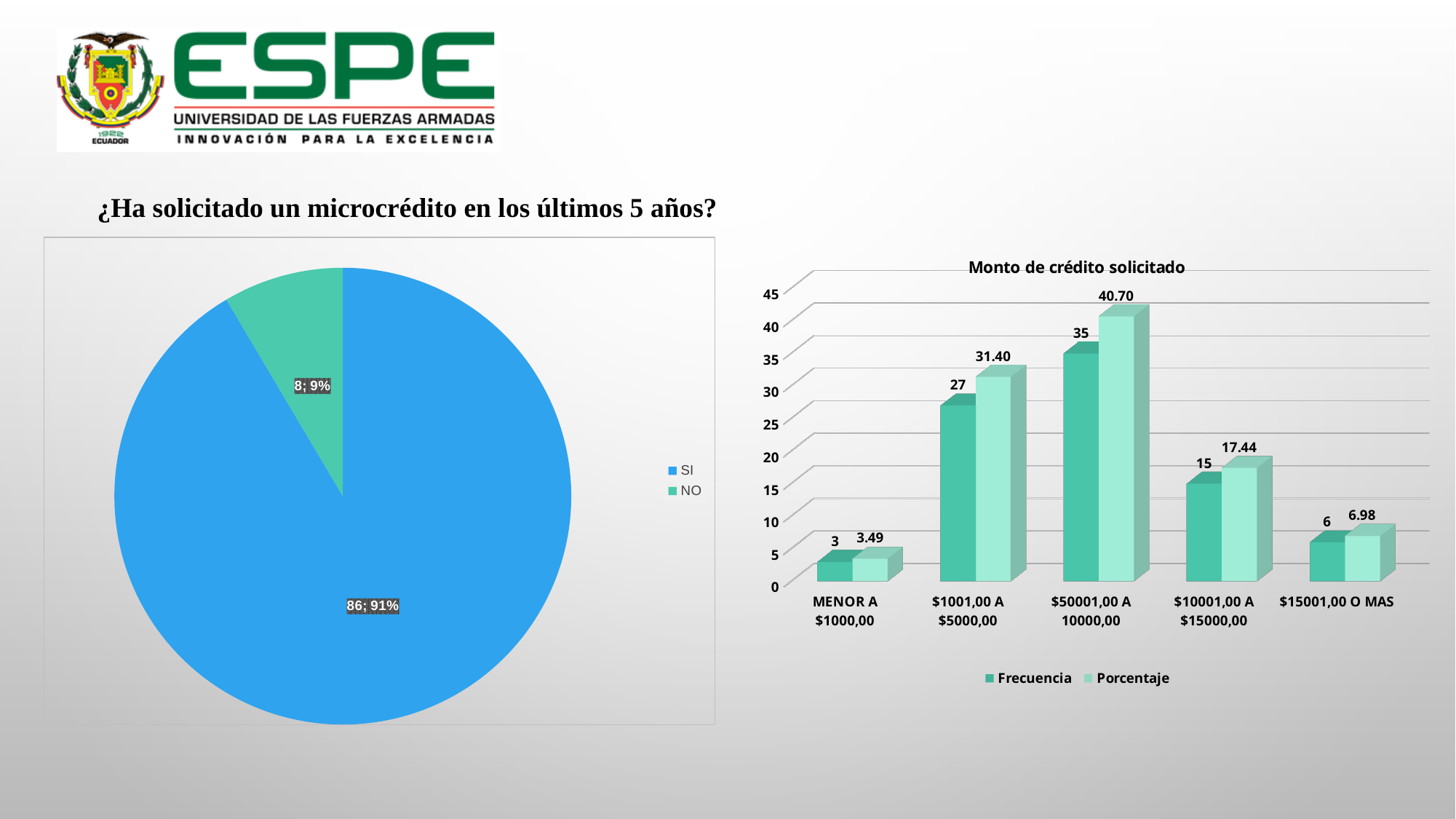
What kind of chart is the chart on the left of the slide? Pie chart In the 'Monto de crédito solicitado' chart, which category has the highest Frecuencia? $50001,00 A 10000,00 In the 'Monto de crédito solicitado' chart, what is the Porcentaje value for $10001,00 A $15000,00? 17.44 What kind of chart is the 'Monto de crédito solicitado' chart? Bar chart In the 'Monto de crédito solicitado' chart, which category has the lowest Porcentaje? MENOR A $1000,00 In the 'Monto de crédito solicitado' chart, which has a larger Frecuencia: $1001,00 A $5000,00 or $10001,00 A $15000,00? $1001,00 A $5000,00 In the 'Monto de crédito solicitado' chart, what is the difference in Frecuencia between $50001,00 A 10000,00 and $15001,00 O MAS? 29 In the 'Monto de crédito solicitado' chart, what is the Frecuencia value for $1001,00 A $5000,00? 27 In the 'Monto de crédito solicitado' chart, how many series does the legend list? 2 In the pie chart on the left, what share of the pie does NO represent? 9% In the pie chart on the left, what is the value shown for SI? 86; 91% In the pie chart on the left, how many slices are there? 2